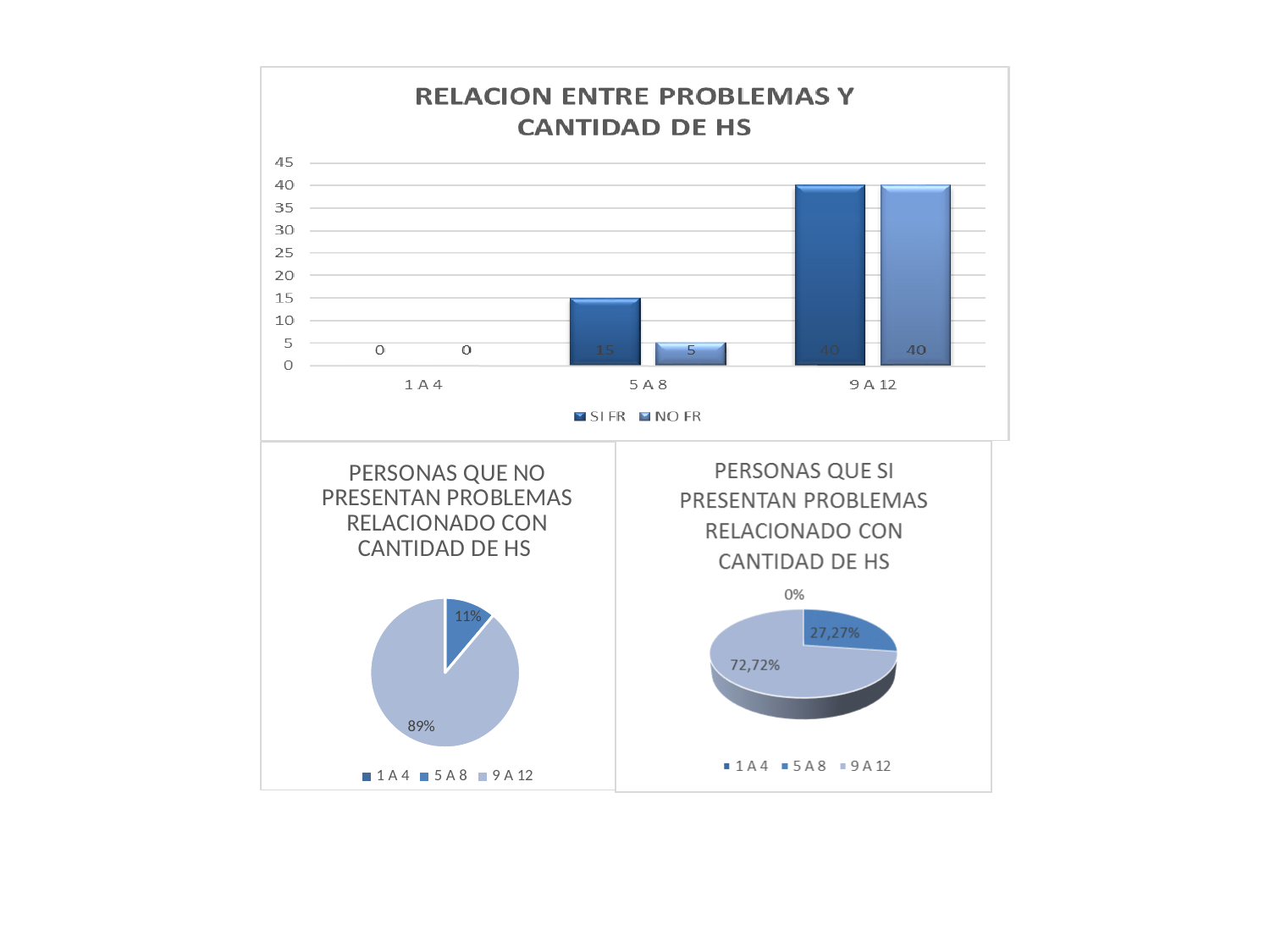
In the bar chart 'RELACION ENTRE PROBLEMAS Y CANTIDAD DE HS', what is the SI FR value for the category 9 A 12? 40 In the bar chart 'RELACION ENTRE PROBLEMAS Y CANTIDAD DE HS', what is the difference between the SI FR and NO FR values for 5 A 8? 10 In the pie chart 'PERSONAS QUE SI PRESENTAN PROBLEMAS RELACIONADO CON CANTIDAD DE HS', what share does the 5 A 8 slice have? 27,27% In the bar chart 'RELACION ENTRE PROBLEMAS Y CANTIDAD DE HS', what is the SI FR value for the category 5 A 8? 15 In the bar chart 'RELACION ENTRE PROBLEMAS Y CANTIDAD DE HS', which is larger for 5 A 8: SI FR or NO FR? SI FR In the bar chart 'RELACION ENTRE PROBLEMAS Y CANTIDAD DE HS', do the SI FR values rise or fall from 1 A 4 to 9 A 12? rise In the bar chart 'RELACION ENTRE PROBLEMAS Y CANTIDAD DE HS', which category has the lowest values for both series? 1 A 4 How many series does the legend of the bar chart 'RELACION ENTRE PROBLEMAS Y CANTIDAD DE HS' list? 2 How many categories are shown on the x axis of the bar chart 'RELACION ENTRE PROBLEMAS Y CANTIDAD DE HS'? 3 What kind of chart is 'PERSONAS QUE SI PRESENTAN PROBLEMAS RELACIONADO CON CANTIDAD DE HS'? pie chart In the pie chart 'PERSONAS QUE NO PRESENTAN PROBLEMAS RELACIONADO CON CANTIDAD DE HS', what share does the 9 A 12 slice have? 89% In the bar chart 'RELACION ENTRE PROBLEMAS Y CANTIDAD DE HS', what is the NO FR value for the category 5 A 8? 5